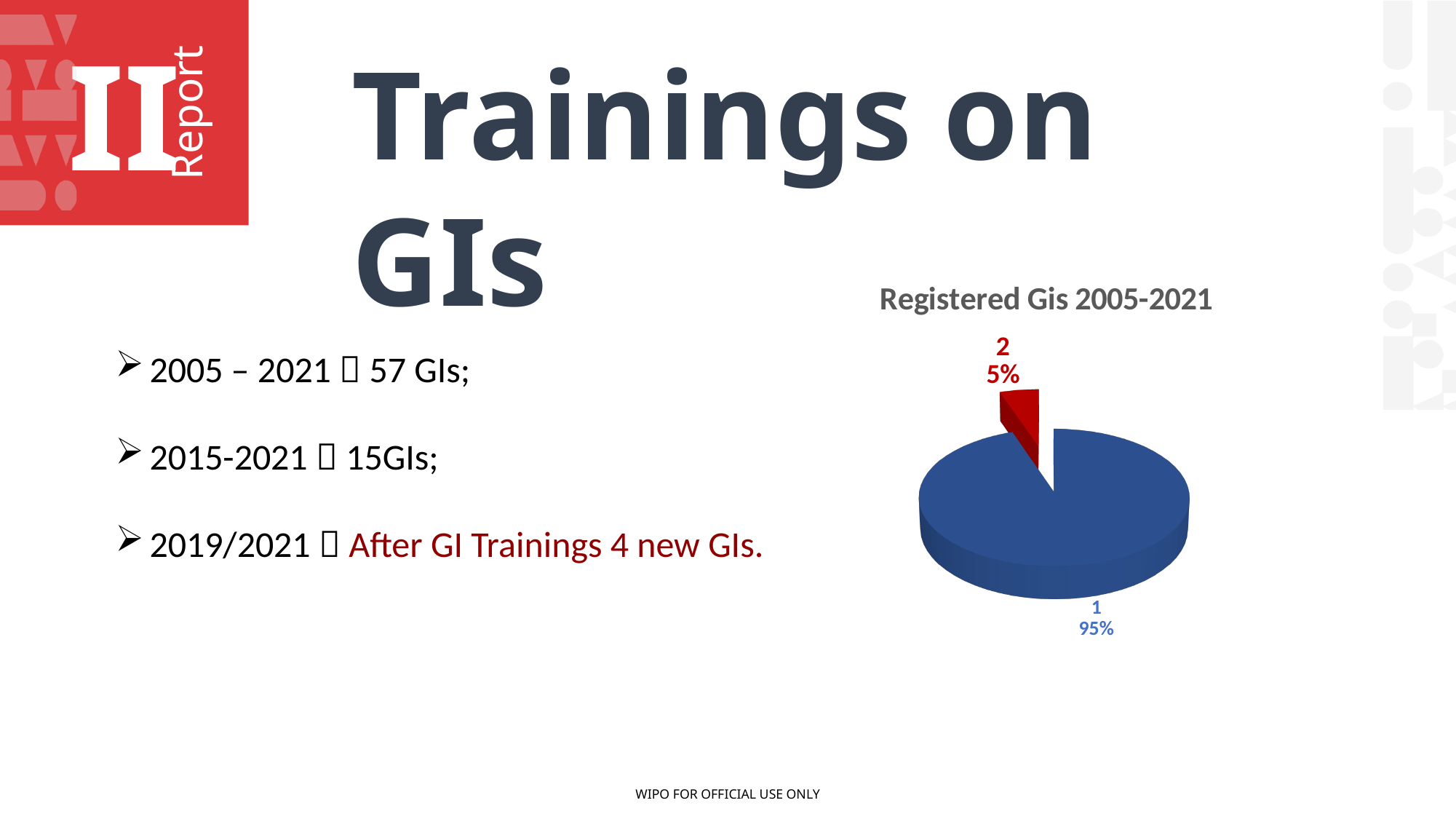
What type of chart is shown under the title "Registered Gis 2005-2021"? pie chart What is the difference in percentage points between slice 1 and slice 2 in the pie chart? 90 What colour is the slice labelled 2 in the pie chart? red What percentage share does slice 2 have in the pie chart? 5% What percentage share does slice 1 have in the pie chart? 95% Which slice is larger in the pie chart, 1 or 2? 1 Which slice of the pie chart is the smallest? 2 What is the title of the chart on the slide? Registered Gis 2005-2021 How many slices does the pie chart have? 2 Which slice of the pie chart is the largest? 1